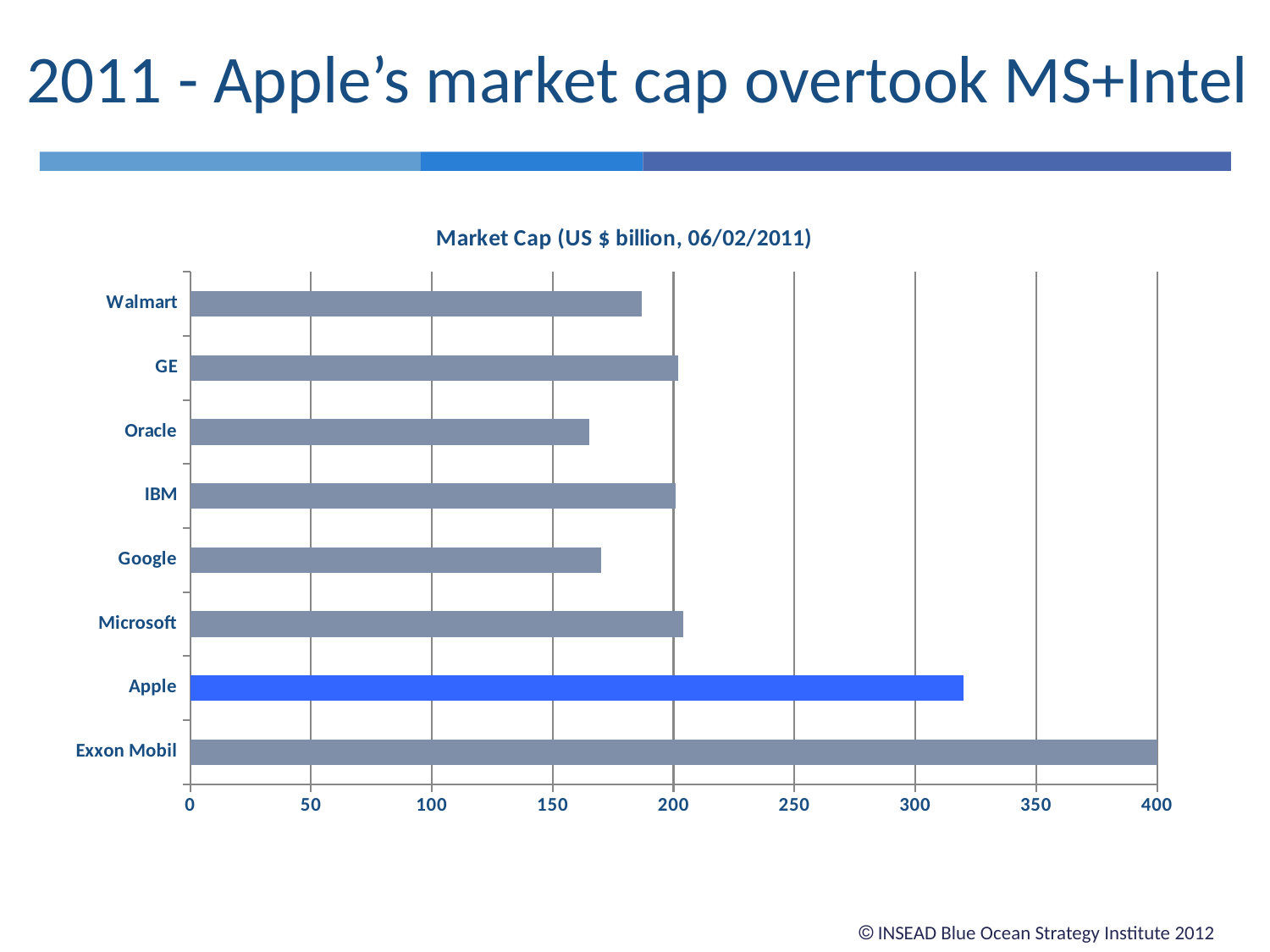
What is the title of the chart? Market Cap (US $ billion, 06/02/2011) What kind of chart is shown on the slide? Bar chart Is the value for Apple greater or less than 350? less Which company has the highest market cap in the chart? Exxon Mobil Is the value for Oracle greater or less than 200? less Which has a larger market cap, Apple or Microsoft? Apple Which has a larger market cap, Walmart or Oracle? Walmart Is the value for Walmart greater or less than 200? less How many companies are shown in the chart? 8 Which company's bar is shown in a different colour (bright blue) from the others? Apple